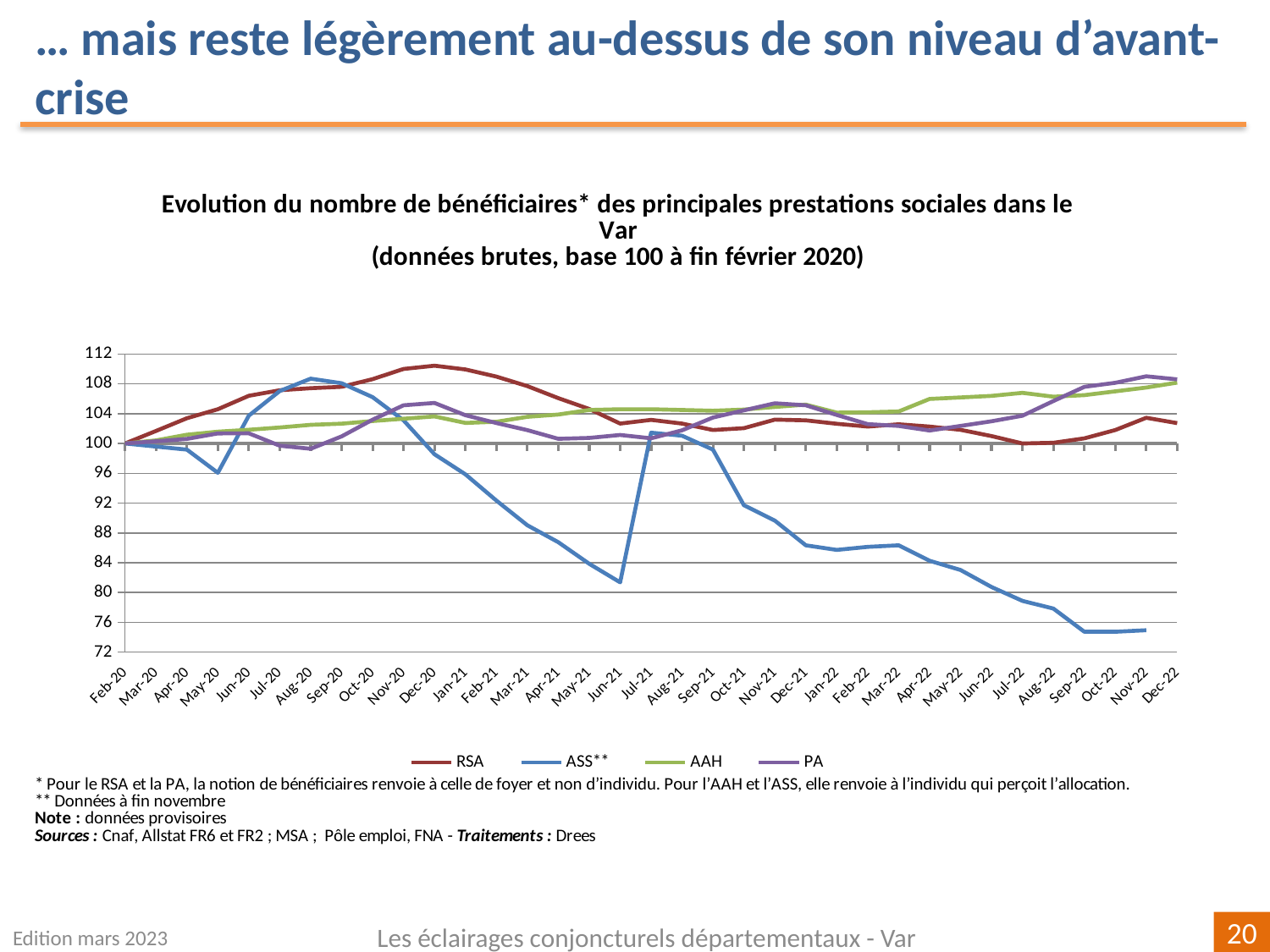
What kind of chart is shown on the slide? line chart How many series does the legend list? 4 Which series has the lowest value in Dec-22? RSA Is the value for RSA in Dec-20 greater or less than 108? greater Is the value for ASS** in Sep-22 greater or less than 80? less Which series are listed in the legend? RSA, ASS**, AAH, PA Which series has the highest value in Dec-20? RSA How many monthly points are plotted along the x axis, from Feb-20 to Dec-22? 35 Does the ASS** series rise or fall between Jul-21 and Dec-22? fall Is the value for ASS** in Dec-21 greater or less than 84? greater